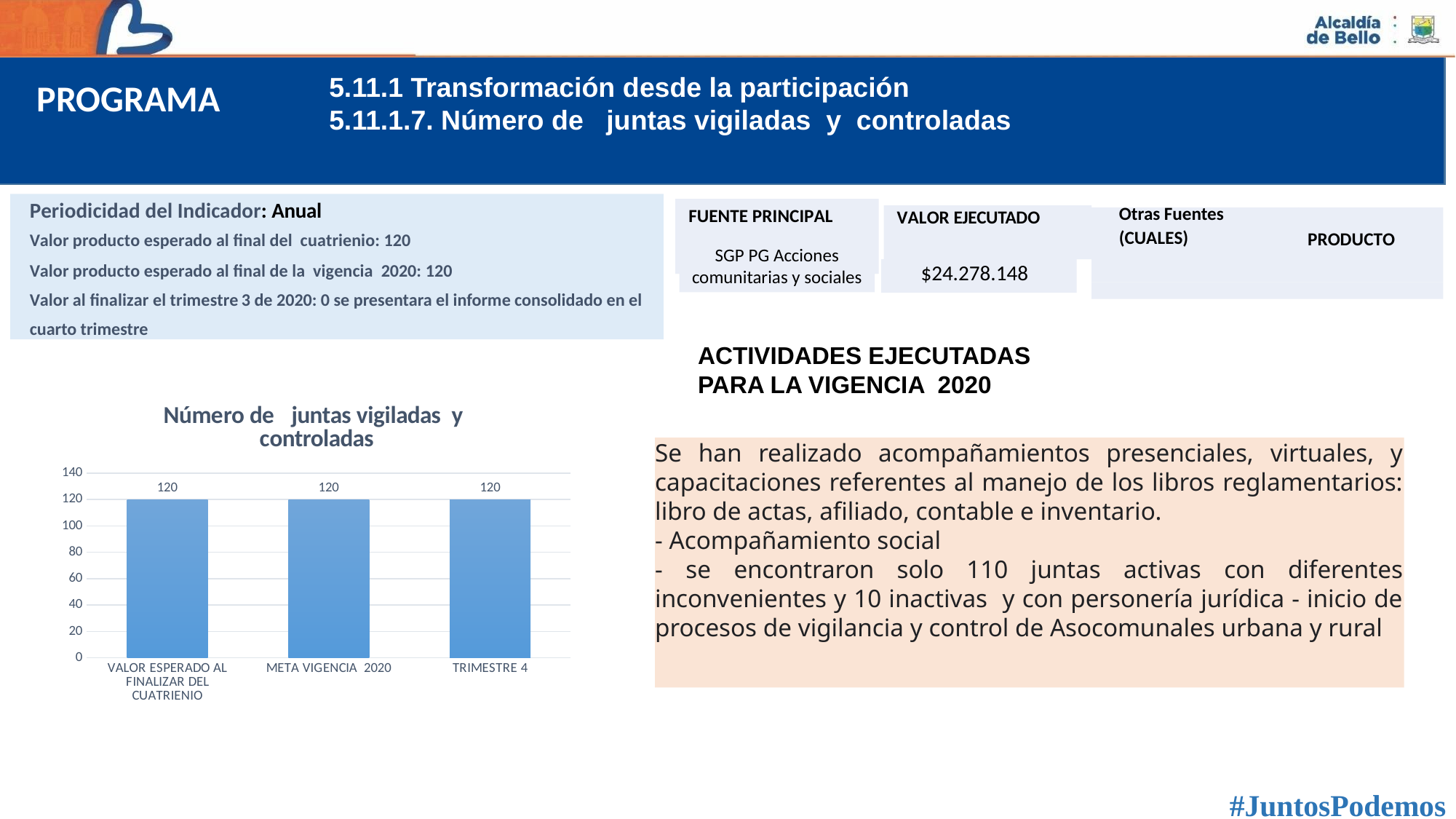
Do the values rise, fall or stay the same across the categories from left to right? stay the same What kind of chart is shown on the slide? bar chart What is the value for VALOR ESPERADO AL FINALIZAR DEL CUATRIENIO in the chart? 120 Is the value for META VIGENCIA 2020 greater or less than 140? less What is the value for META VIGENCIA 2020 in the chart? 120 What is the title of the chart? Número de juntas vigiladas y controladas What is the value for TRIMESTRE 4 in the chart? 120 How many categories are shown on the x axis of the chart? 3 Is the value for TRIMESTRE 4 greater or less than 100? greater What is the difference between the values for META VIGENCIA 2020 and TRIMESTRE 4? 0 What is the highest value shown on the y axis of the chart? 140